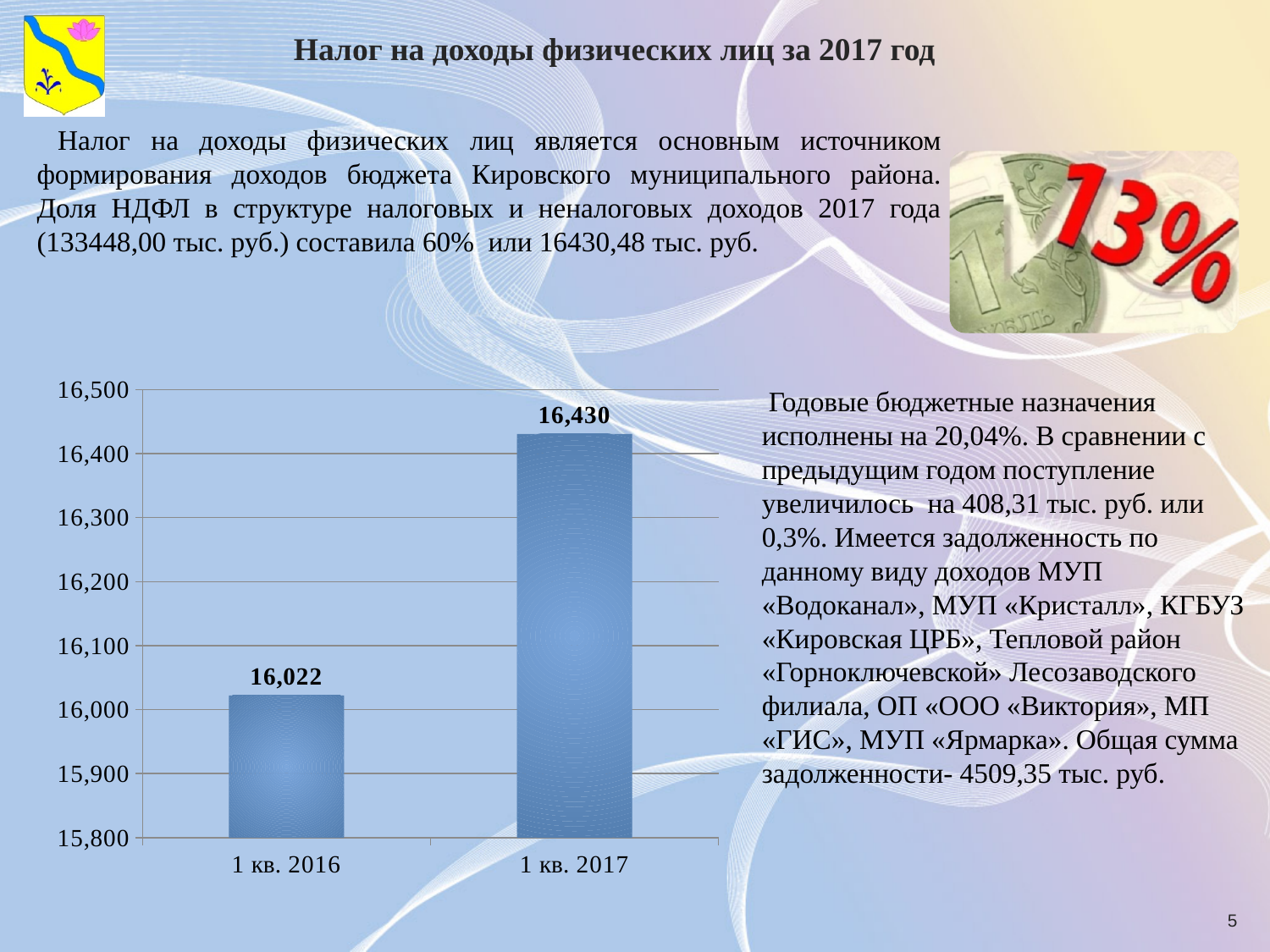
What is the difference between the values for 1 кв. 2017 and 1 кв. 2016? 408 Which category has the highest value? 1 кв. 2017 What is the lowest value shown on the vertical axis of the chart? 15,800 How many categories are shown on the chart? 2 Which is larger, the value for 1 кв. 2016 or the value for 1 кв. 2017? 1 кв. 2017 What is the value for 1 кв. 2016? 16,022 What is the value for 1 кв. 2017? 16,430 Which category has the lowest value? 1 кв. 2016 Is the value for 1 кв. 2017 greater or less than 16,400? greater Do the values rise or fall from 1 кв. 2016 to 1 кв. 2017? rise Is the value for 1 кв. 2016 greater or less than 16,100? less What kind of chart is shown on the slide? bar chart